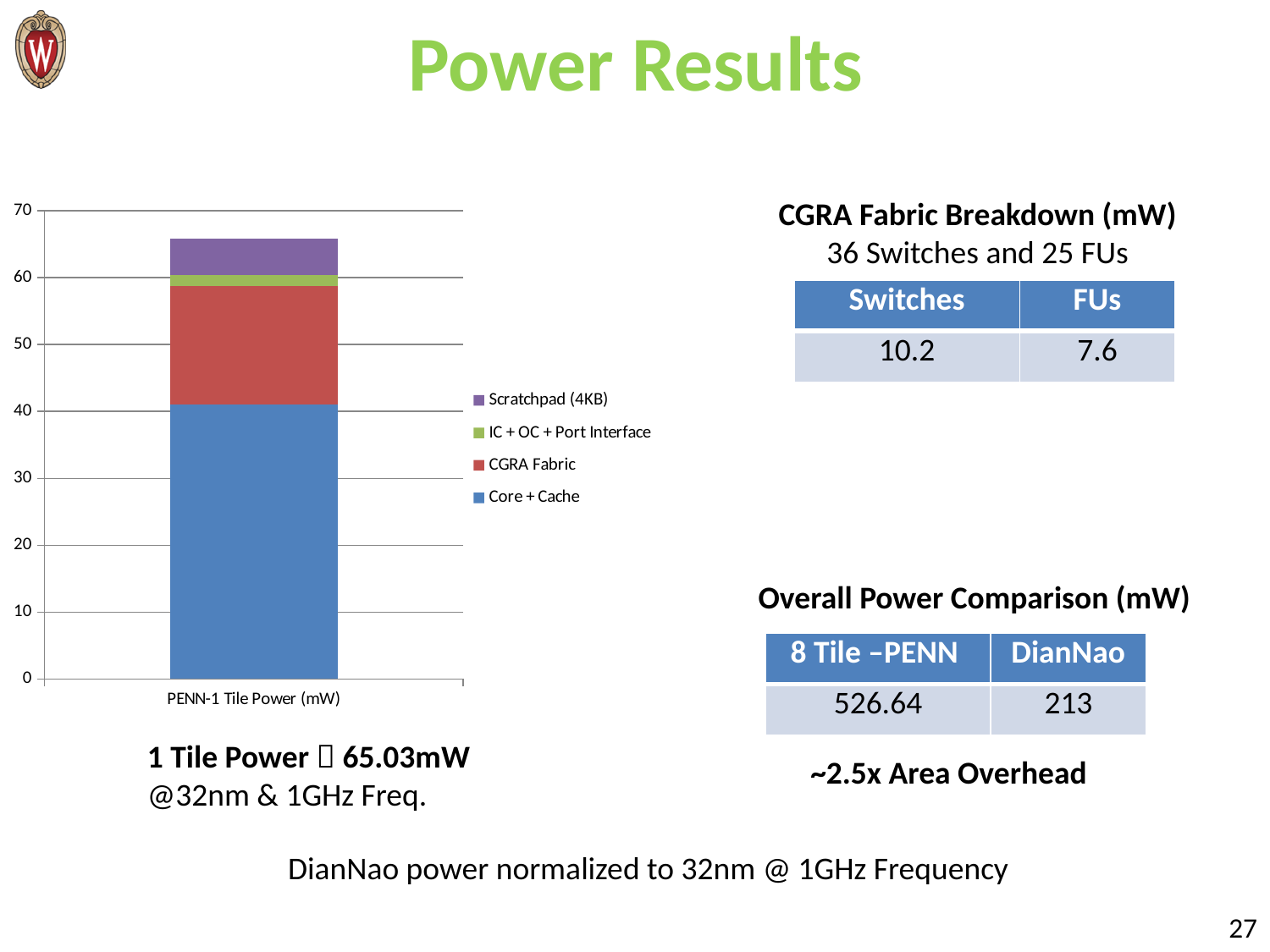
Is the Core + Cache segment larger or smaller than the CGRA Fabric segment? Larger Which series contributes the largest segment to the stacked bar? Core + Cache How many categories are plotted on the x axis of the chart? 1 What colour is the Core + Cache segment in the chart? Blue What kind of chart is shown on the slide? Stacked bar chart Is the total height of the stacked bar greater or less than 60? greater Is the Scratchpad (4KB) segment larger or smaller than the IC + OC + Port Interface segment? Larger Is the value for Core + Cache greater or less than 40? greater Is the value for CGRA Fabric greater or less than 20? less What is the label of the single category on the chart's x axis? PENN-1 Tile Power (mW) Which series contributes the smallest segment to the stacked bar? IC + OC + Port Interface How many series does the chart legend list? 4